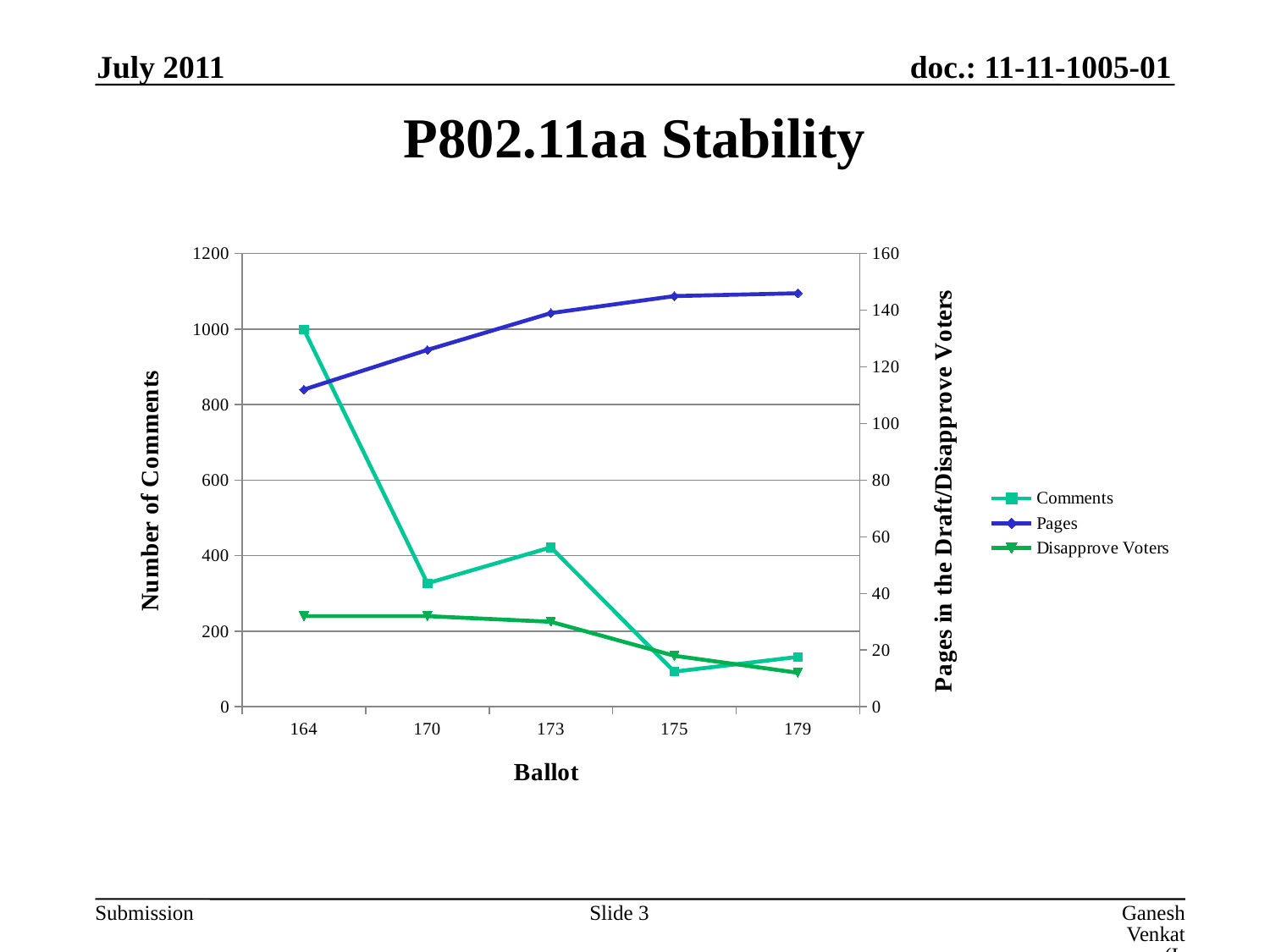
What is the title of the x axis? Ballot Which ballot has more Comments, 170 or 173? 173 At which ballot is the number of Comments lowest? 175 Does the Pages series rise or fall from ballot 164 to ballot 179? rise Is the number of Comments at ballot 170 greater or less than 400? less How many ballot values are plotted along the x axis? 5 Is the Pages value at ballot 179 greater or less than 140? greater Is the Pages value at ballot 164 greater or less than 120? less At which ballot is the number of Comments highest? 164 What kind of chart is shown on the slide? line chart How many series does the legend list? 3 Does the Disapprove Voters series rise or fall from ballot 164 to ballot 179? fall